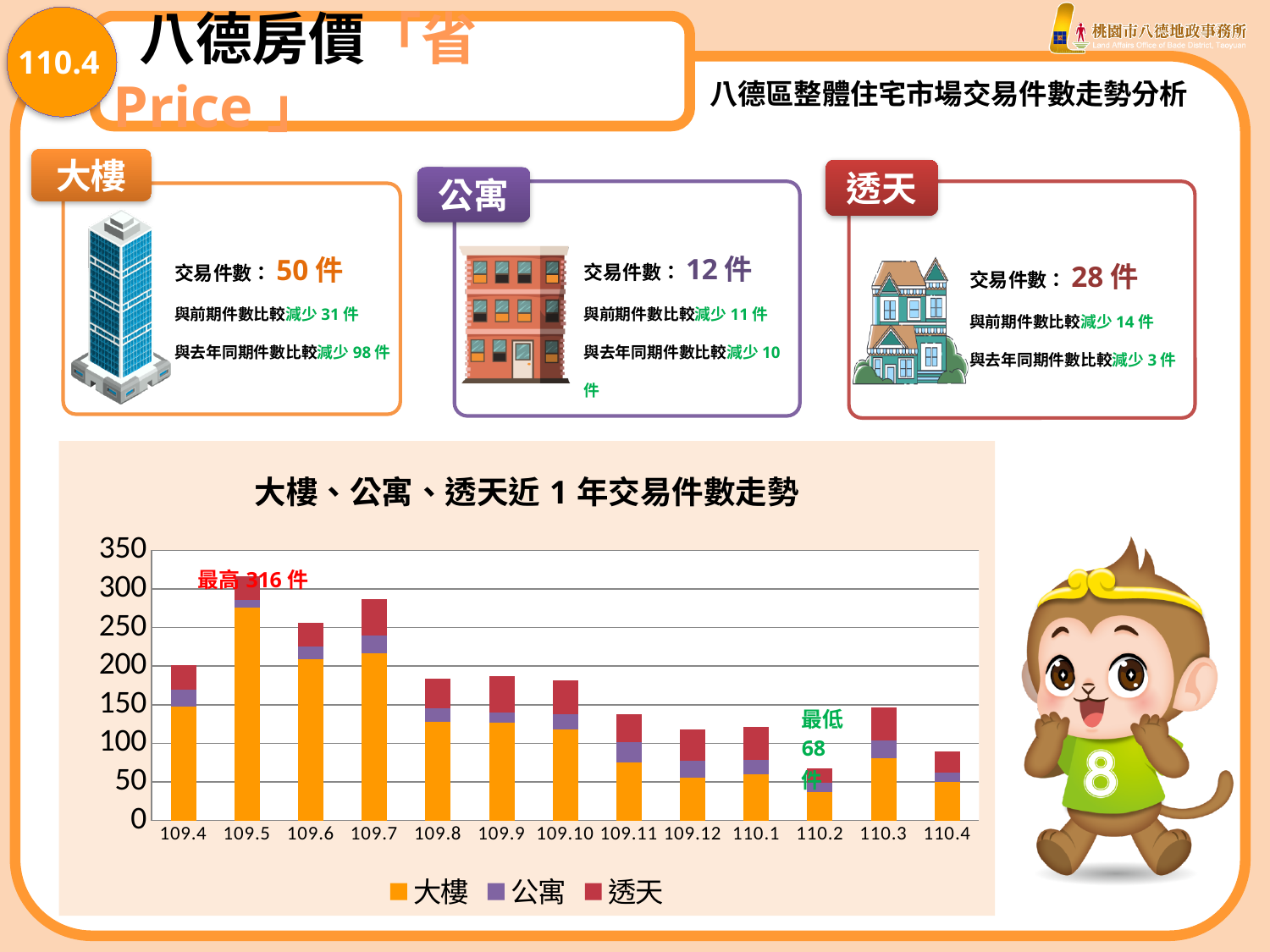
What is the title of the chart? 大樓、公寓、透天近 1 年交易件數走勢 Is the total value of the bar for 109.4 greater or less than 150? greater How many months (categories) are shown on the x axis of the chart? 13 What is the highest total number of transactions labelled on the chart? 316 件 Which month has a taller stacked bar, 109.7 or 109.8? 109.7 Is the total value of the bar for 110.4 greater or less than 100? less Which month has the highest total number of transactions in the chart? 109.5 What kind of chart is shown on the slide? bar chart What is the difference between the highest (109.5) and lowest (110.2) labelled totals in the chart? 248 件 Which month has the lowest total number of transactions in the chart? 110.2 How many series does the legend of the chart list? 3 What is the lowest total number of transactions labelled on the chart? 68 件